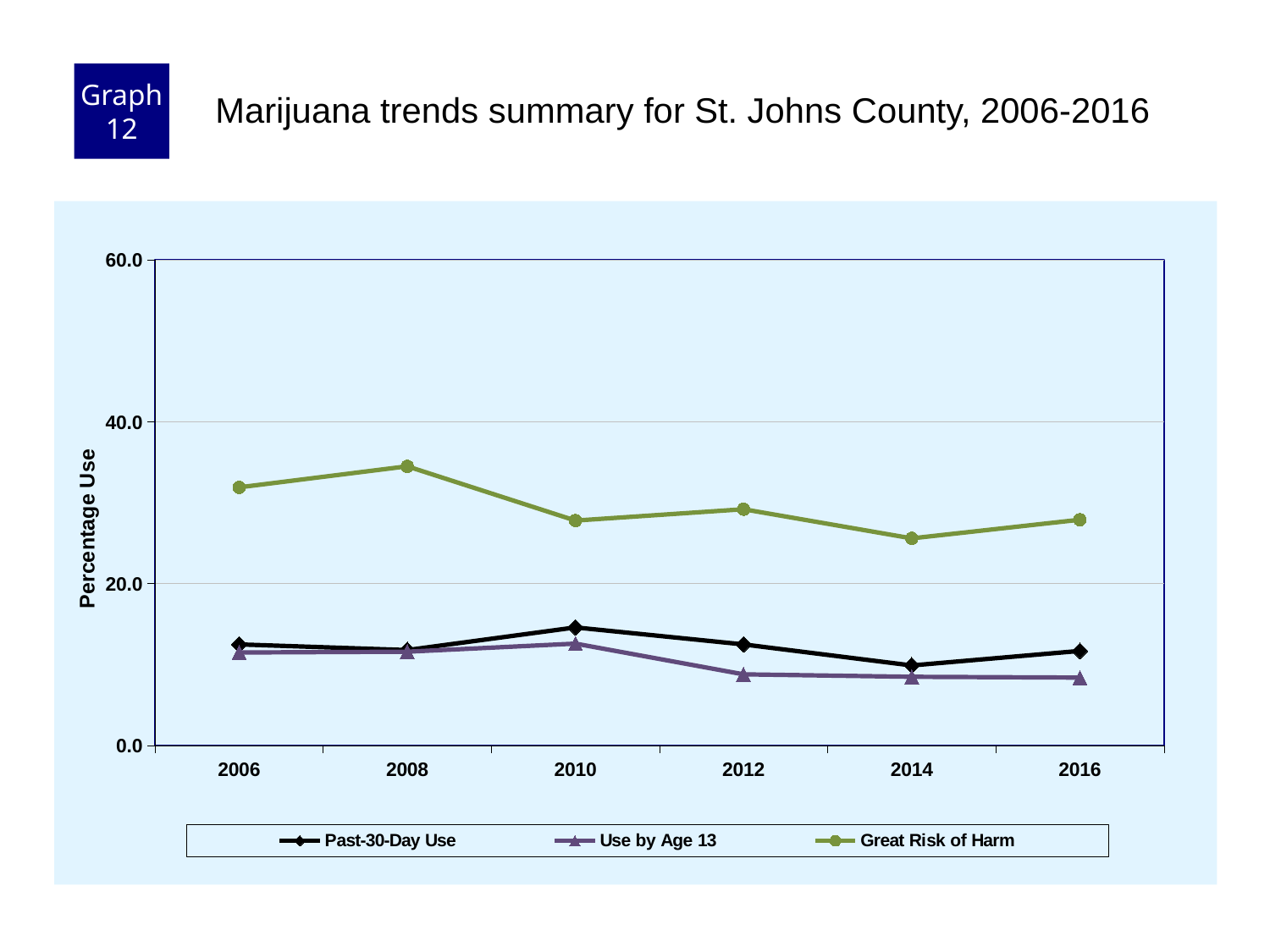
How many series does the legend list? 3 Is the Great Risk of Harm value for 2008 greater or less than 40.0? less In which year is the Great Risk of Harm value highest? 2008 What type of chart is shown on the slide? Line chart In which year is the Past-30-Day Use value lowest? 2014 Is the Past-30-Day Use value for 2010 greater or less than 20.0? less In which year is the Great Risk of Harm value lowest? 2014 Is the Great Risk of Harm value for 2014 greater or less than 20.0? greater Which series has the higher value in 2012: Past-30-Day Use or Use by Age 13? Past-30-Day Use What is the label on the y axis? Percentage Use In which year is the Past-30-Day Use value highest? 2010 How many years are plotted along the x axis? 6